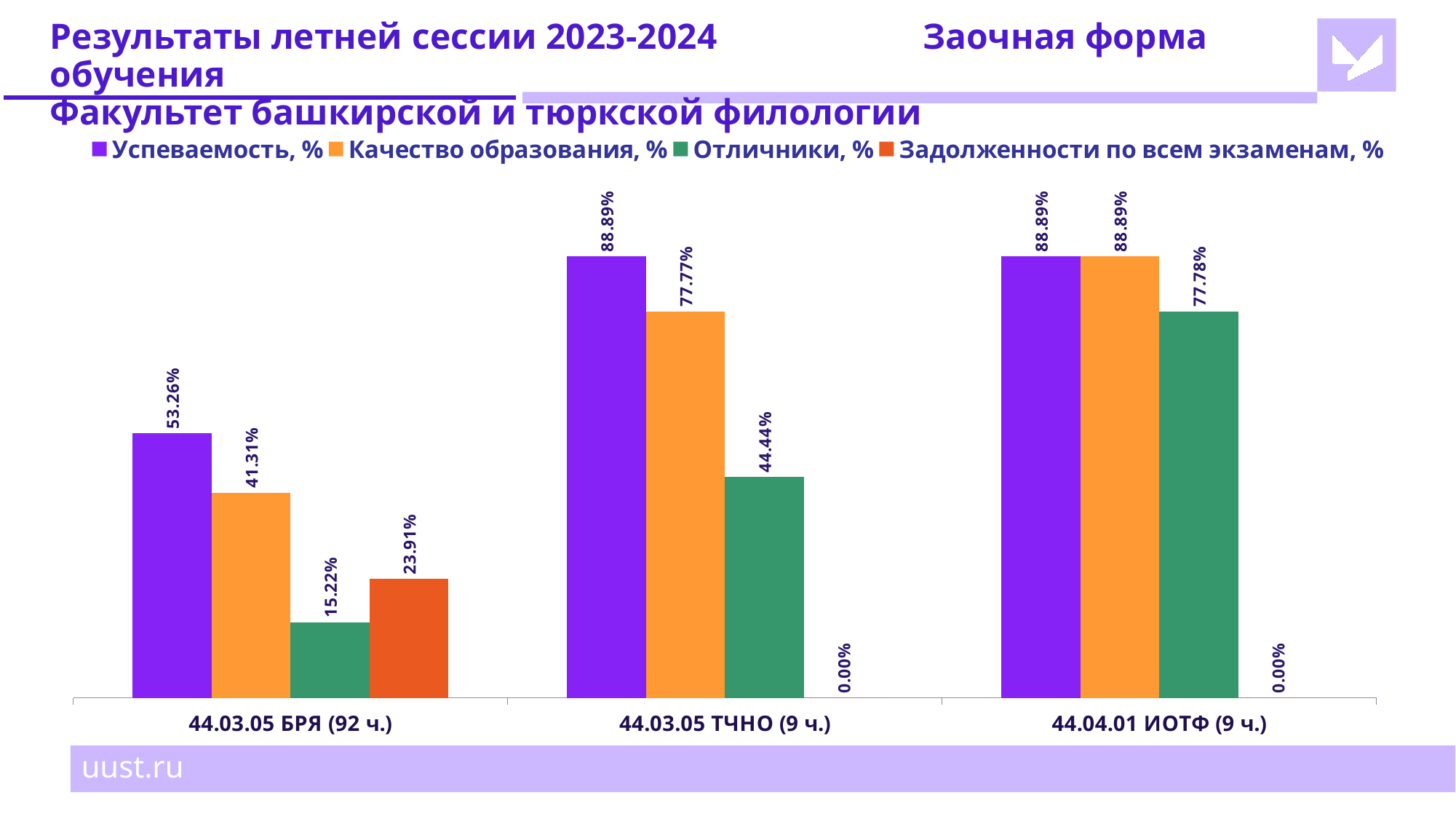
How many series does the legend list? 4 Which is larger: Качество образования, % for 44.03.05 БРЯ (92 ч.) or Отличники, % for 44.03.05 ТЧНО (9 ч.)? Отличники, % for 44.03.05 ТЧНО (9 ч.) How many categories are shown on the x axis? 3 What is the value of Качество образования, % for 44.03.05 ТЧНО (9 ч.)? 77.77% Which category has the lowest value for Успеваемость, %? 44.03.05 БРЯ (92 ч.) Which colour represents Отличники, % in the legend? Green What is the value of Отличники, % for 44.04.01 ИОТФ (9 ч.)? 77.78% What is the value of Задолженности по всем экзаменам, % for 44.03.05 БРЯ (92 ч.)? 23.91% Which category has the highest value for Задолженности по всем экзаменам, %? 44.03.05 БРЯ (92 ч.) What kind of chart is shown on the slide? Bar chart What is the value of Успеваемость, % for 44.03.05 БРЯ (92 ч.)? 53.26% What is the difference between Отличники, % for 44.04.01 ИОТФ (9 ч.) and for 44.03.05 ТЧНО (9 ч.)? 33.34%